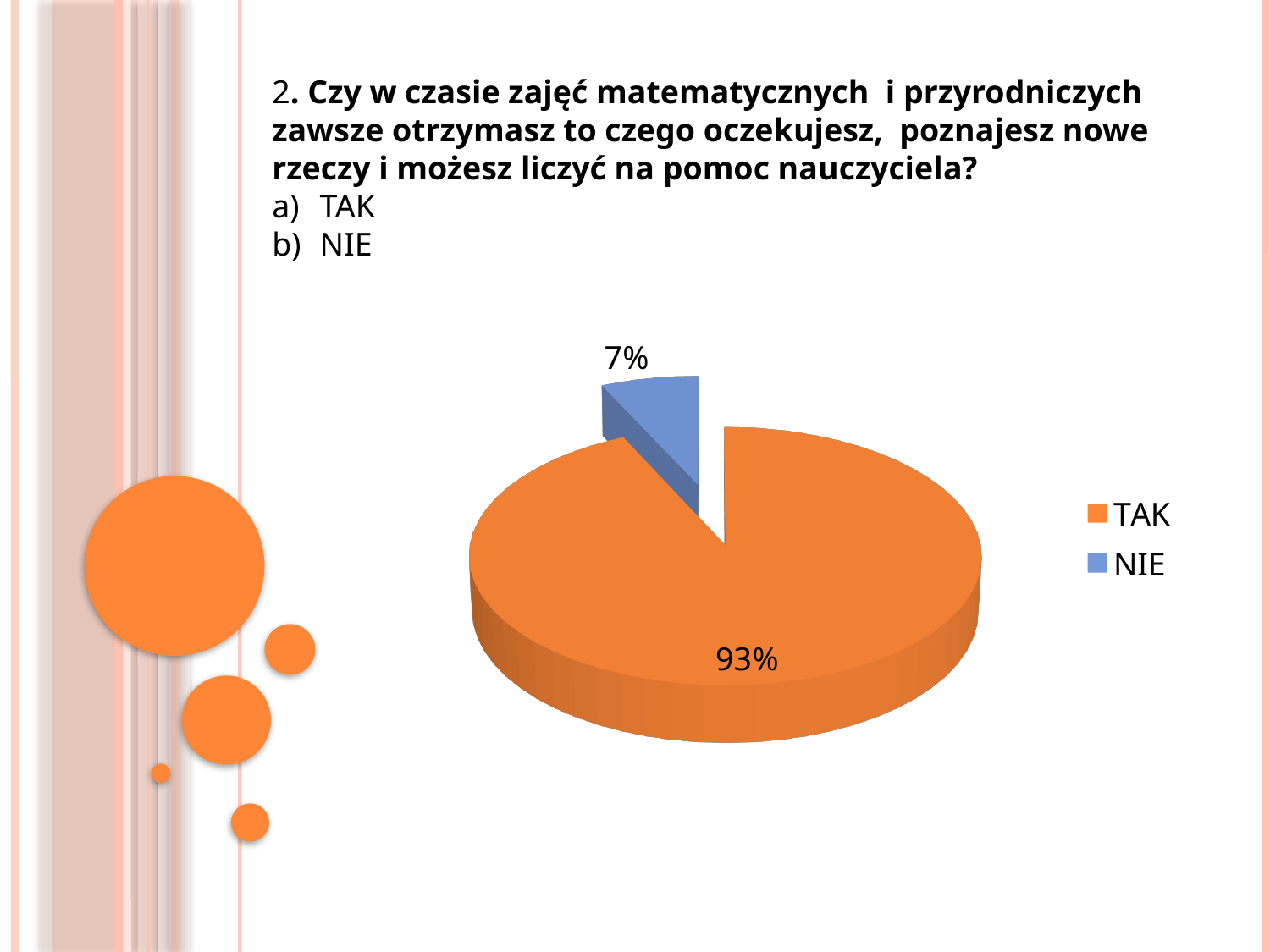
What share of the pie does NIE represent? 7% What share of the pie does TAK represent? 93% Which category has the largest slice of the pie? TAK What colour is the TAK slice in the pie chart? orange How many entries does the legend list? 2 What colour is the NIE slice in the pie chart? blue What is the difference in percentage points between the TAK and NIE slices? 86 What kind of chart is shown on the slide? pie chart How many categories does the pie chart show? 2 Which is larger, the TAK slice or the NIE slice? TAK Which category has the smallest slice of the pie? NIE